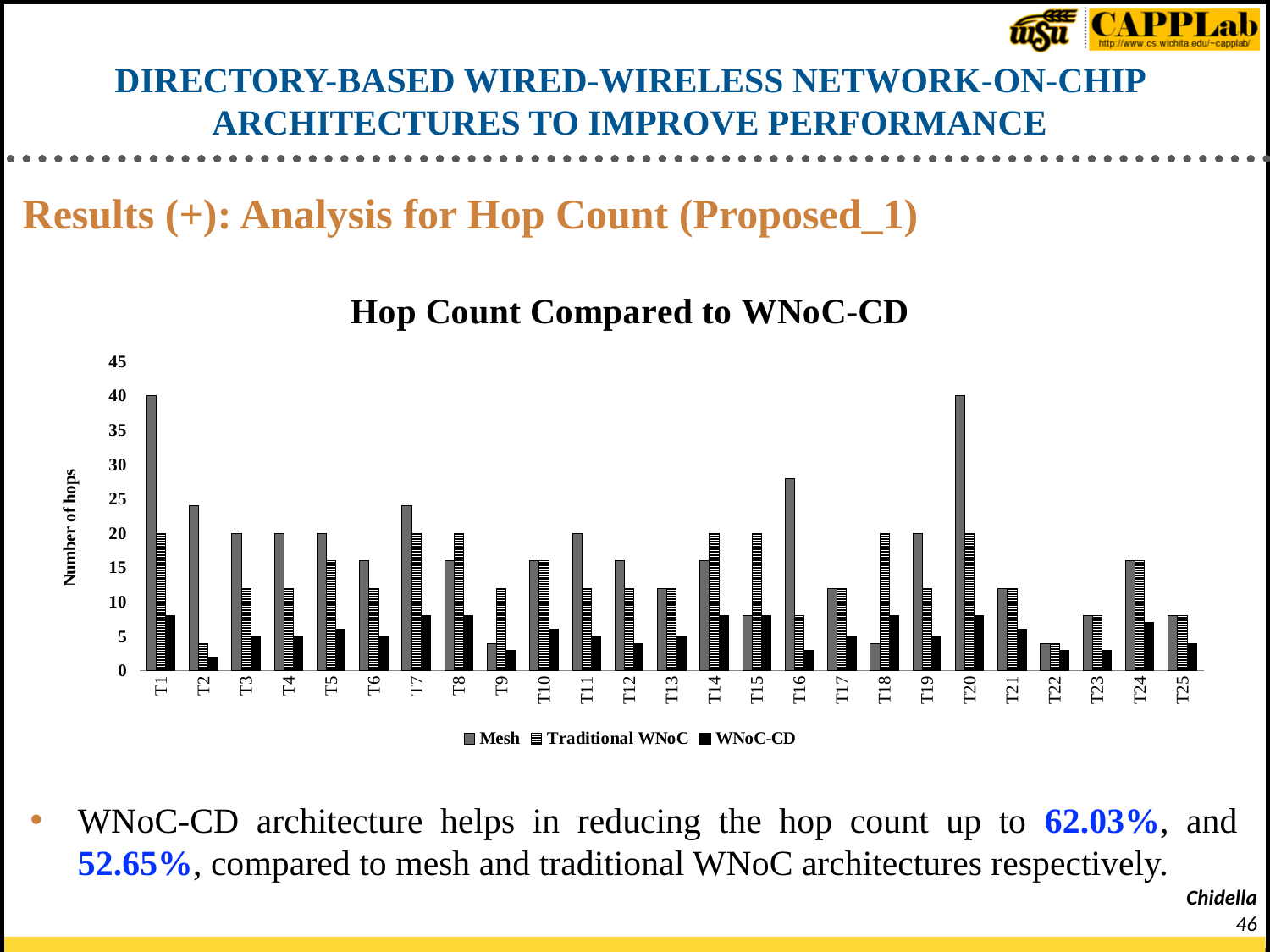
What is the difference between the Mesh and Traditional WNoC values for T1? 20 What is the Mesh value for T20? 40 What is the label on the y axis of the chart? Number of hops Is the Mesh value for T16 greater or less than 25? greater Is the Mesh value for T9 greater or less than 5? less What is the Traditional WNoC value for T1? 20 What is the Mesh value for T1? 40 For T18, which is larger: the Mesh value or the Traditional WNoC value? Traditional WNoC How many series does the legend list? 3 What kind of chart is shown on the slide? bar chart For T1, which is larger: the Mesh value or the WNoC-CD value? Mesh How many categories (T1 to T25) are plotted on the x axis? 25